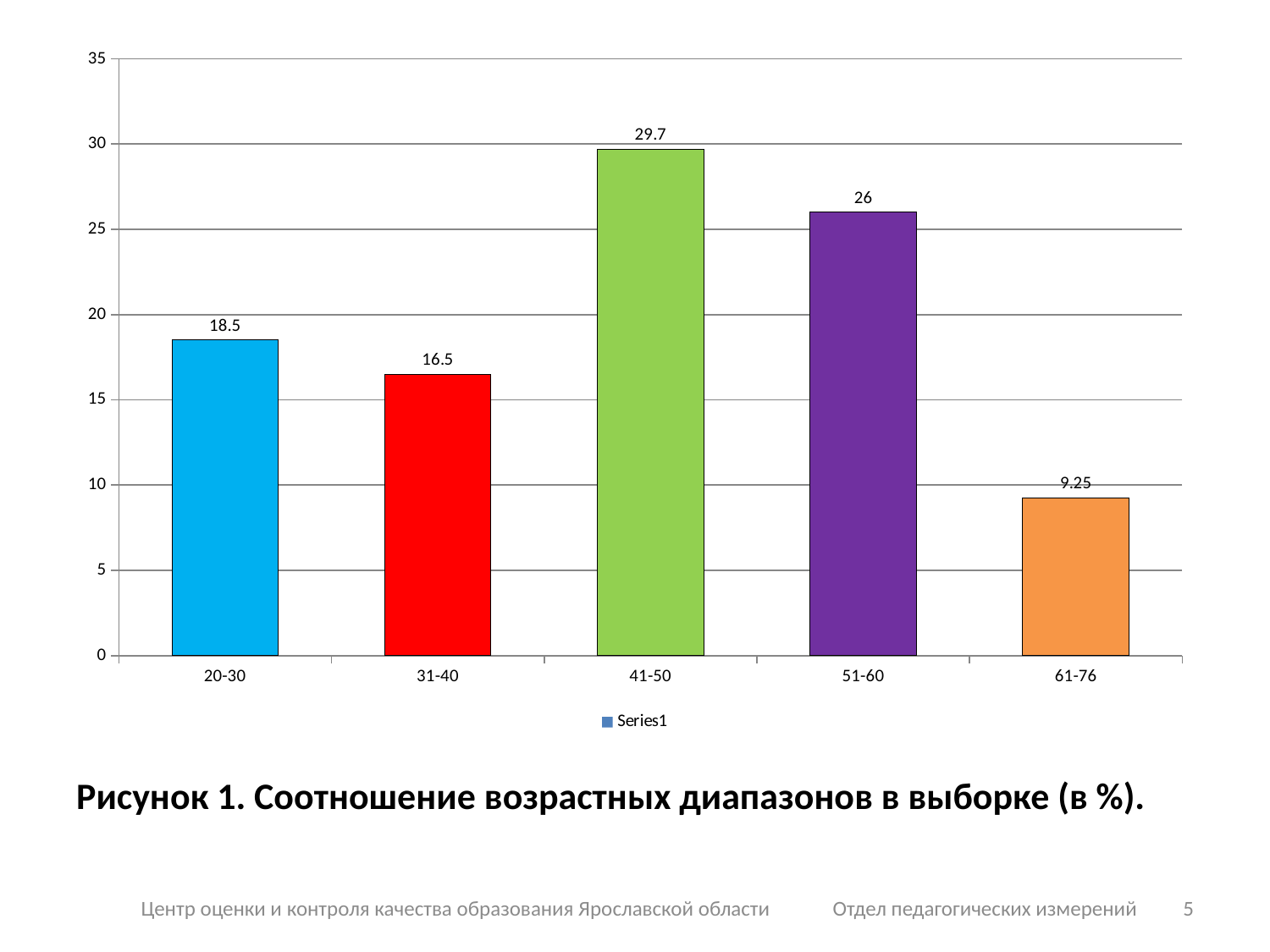
Which is larger, the value for 20-30 or the value for 31-40? 20-30 What kind of chart is shown on the slide? bar chart Is the value for 51-60 greater or less than 25? greater How many age ranges are shown on the x axis? 5 What is the value for the 41-50 age range? 29.7 Which age range has the highest value? 41-50 What is the value for the 20-30 age range? 18.5 What is the difference between the values for 20-30 and 31-40? 2 What is the difference between the values for 41-50 and 51-60? 3.7 Which age range has the lowest value? 61-76 What is the value for the 61-76 age range? 9.25 What is the name of the series listed in the legend? Series1